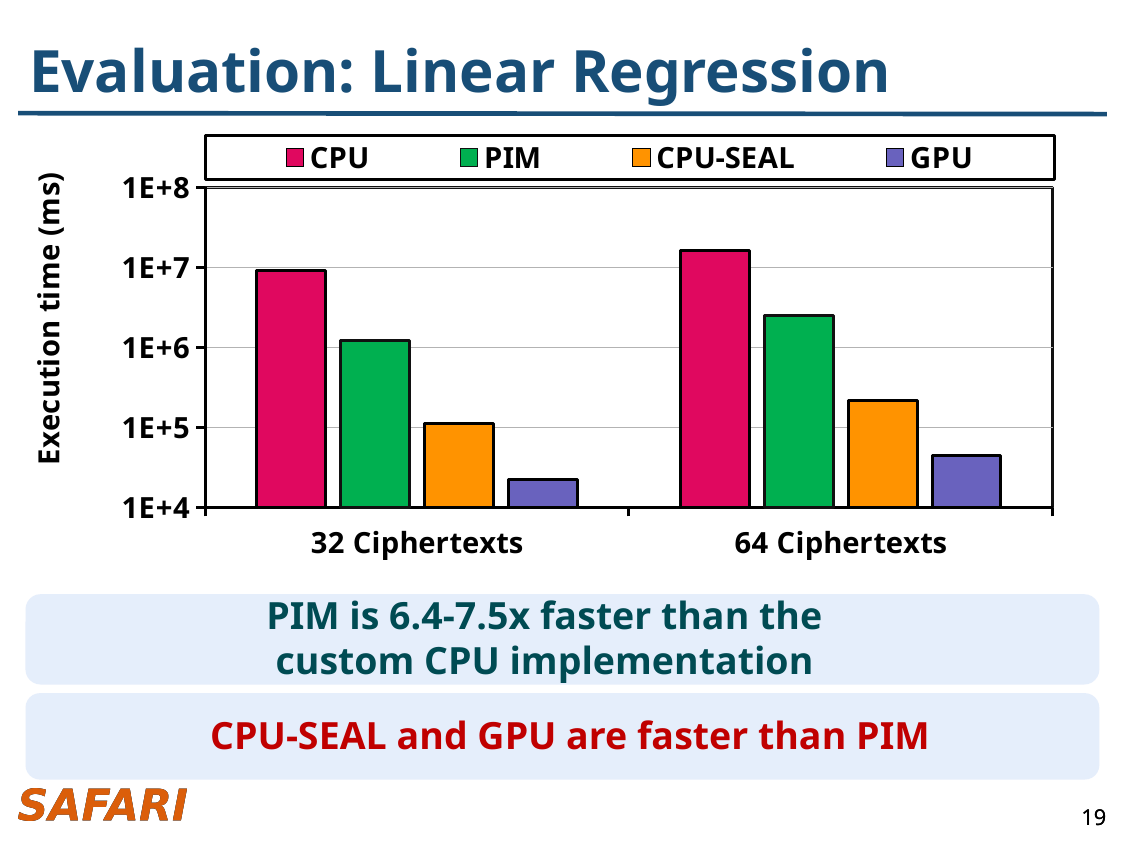
Which series has the lowest execution time for 32 Ciphertexts? GPU For 32 Ciphertexts, which has the larger execution time, PIM or CPU-SEAL? PIM Which series has the lowest execution time for 64 Ciphertexts? GPU Which series has the highest execution time for 64 Ciphertexts? CPU Is the execution time for GPU at 64 Ciphertexts greater or less than 1E+5? less How many categories are shown on the x axis? 2 How many series does the legend list? 4 Is the execution time for CPU at 64 Ciphertexts greater or less than 1E+7? greater Is the execution time for PIM at 64 Ciphertexts greater or less than 1E+6? greater What kind of chart is shown on the slide? bar chart What is the label of the y axis? Execution time (ms) Does the execution time for PIM rise or fall from 32 Ciphertexts to 64 Ciphertexts? rise